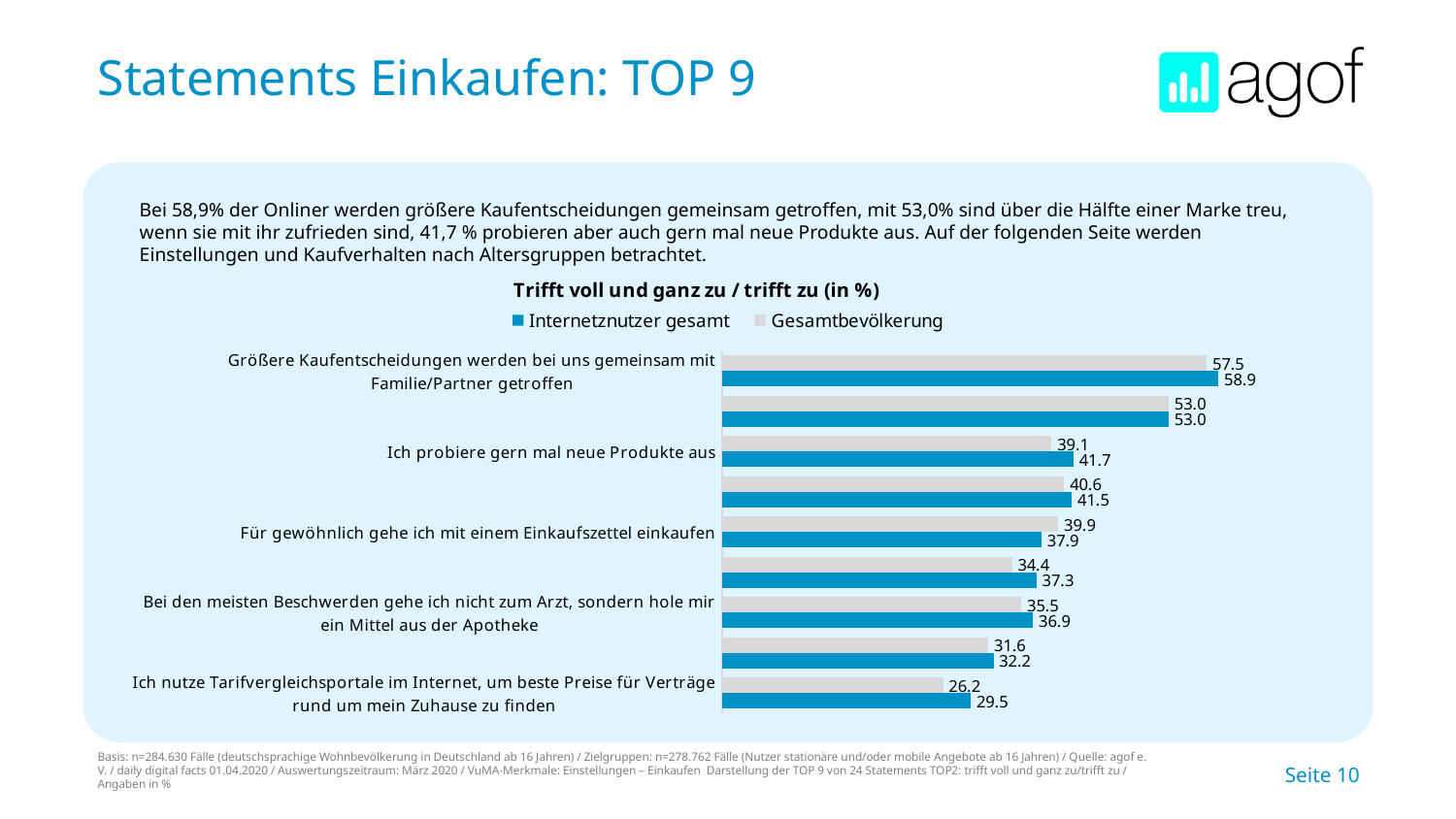
Which statement has the lowest value for Gesamtbevölkerung? Ich nutze Tarifvergleichsportale im Internet, um beste Preise für Verträge rund um mein Zuhause zu finden What is the value for Gesamtbevölkerung for 'Für gewöhnlich gehe ich mit einem Einkaufszettel einkaufen'? 39.9 What type of chart is shown on the slide? bar chart What is the value for Gesamtbevölkerung for the statement 'Größere Kaufentscheidungen werden bei uns gemeinsam mit Familie/Partner getroffen'? 57.5 For 'Bei den meisten Beschwerden gehe ich nicht zum Arzt, sondern hole mir ein Mittel aus der Apotheke', which is larger: Internetznutzer gesamt or Gesamtbevölkerung? Internetznutzer gesamt How many statements (categories) are plotted in the chart? 9 Which statement has the highest value for Internetznutzer gesamt? Größere Kaufentscheidungen werden bei uns gemeinsam mit Familie/Partner getroffen What is the value for Internetznutzer gesamt for 'Ich nutze Tarifvergleichsportale im Internet, um beste Preise für Verträge rund um mein Zuhause zu finden'? 29.5 How many series does the legend list? 2 What is the value for Internetznutzer gesamt for the statement 'Größere Kaufentscheidungen werden bei uns gemeinsam mit Familie/Partner getroffen'? 58.9 What is the difference between Internetznutzer gesamt and Gesamtbevölkerung for 'Ich probiere gern mal neue Produkte aus'? 2.6 What is the value for Internetznutzer gesamt for 'Ich probiere gern mal neue Produkte aus'? 41.7